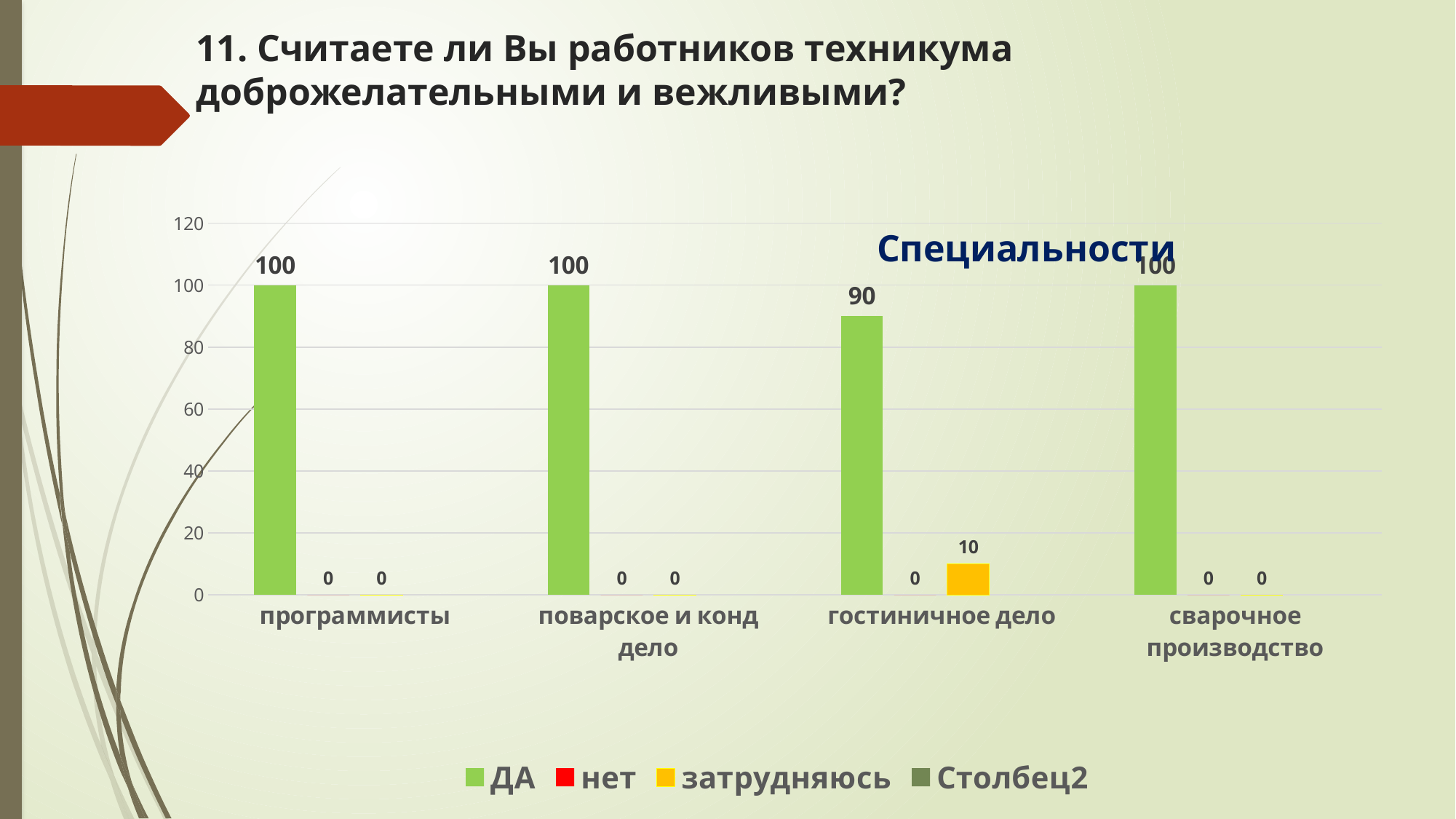
How many categories are shown on the x axis? 4 Which category has the highest value for затрудняюсь? гостиничное дело Which is larger for гостиничное дело: the ДА value or the затрудняюсь value? ДА What is the difference between the ДА value for программисты and the ДА value for гостиничное дело? 10 What is the value of ДА for гостиничное дело? 90 How many series does the legend list? 4 What colour represents the ДА series in the legend? green What is the value of ДА for программисты? 100 What kind of chart is shown on the slide? bar chart What is the value of нет for сварочное производство? 0 Which category has the lowest value for ДА? гостиничное дело What is the value of затрудняюсь for гостиничное дело? 10